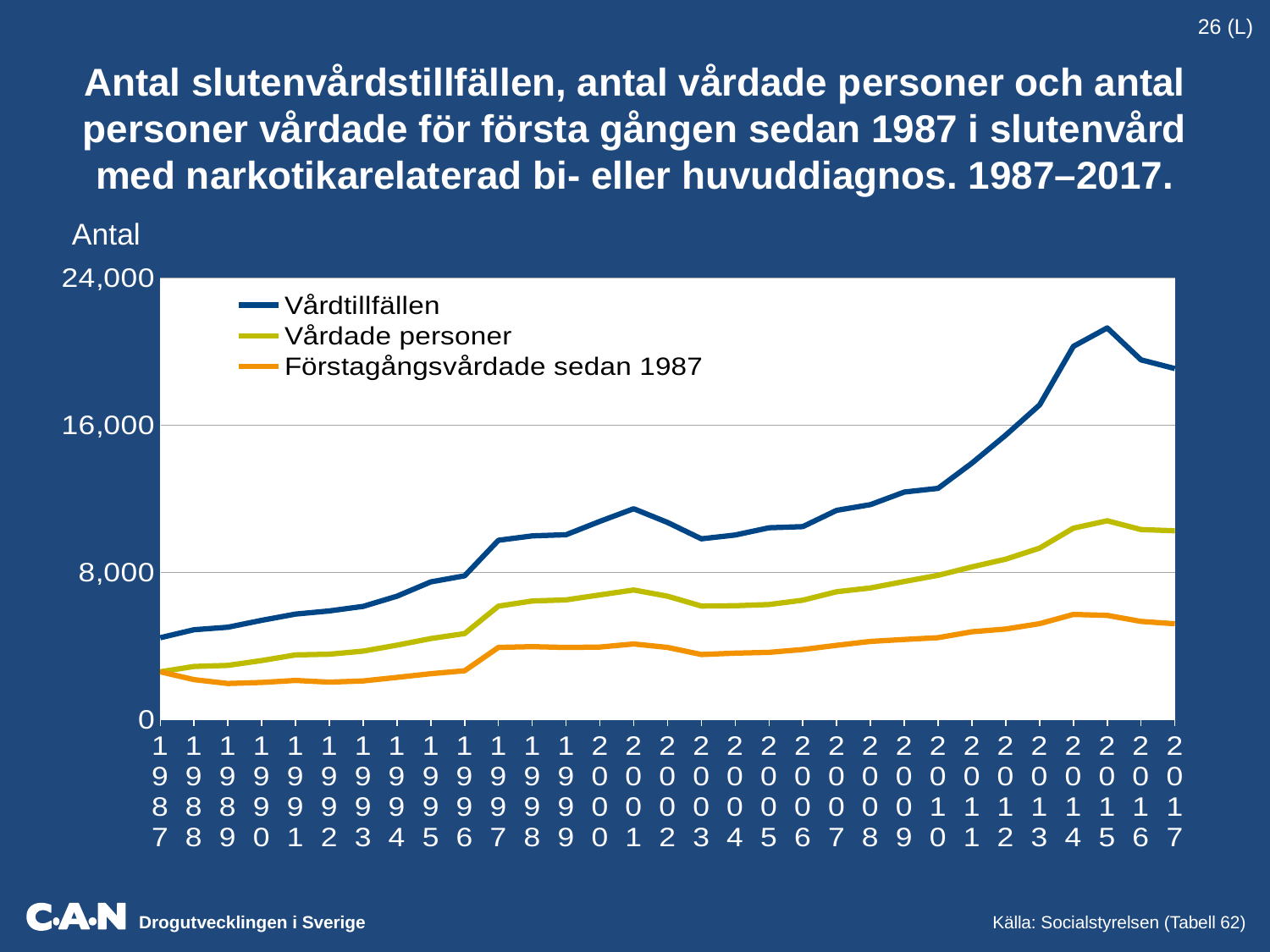
What is the label on the vertical axis? Antal In which year is the Vårdtillfällen series at its lowest value? 1987 Is the value for Vårdtillfällen in 2015 greater or less than 16,000? greater Which series is drawn in orange? Förstagångsvårdade sedan 1987 Is the value for Förstagångsvårdade sedan 1987 in 2017 greater or less than 8,000? less In which year does the Vårdtillfällen series reach its highest value? 2015 What kind of chart is shown on the slide? Line chart How many years are plotted along the x axis? 31 Does the Vårdtillfällen series generally rise or fall from 1987 to 2015? rise Is the value for Vårdade personer in 2017 greater or less than 8,000? greater How many series does the legend list? 3 In 2017, which is larger: Vårdtillfällen or Förstagångsvårdade sedan 1987? Vårdtillfällen